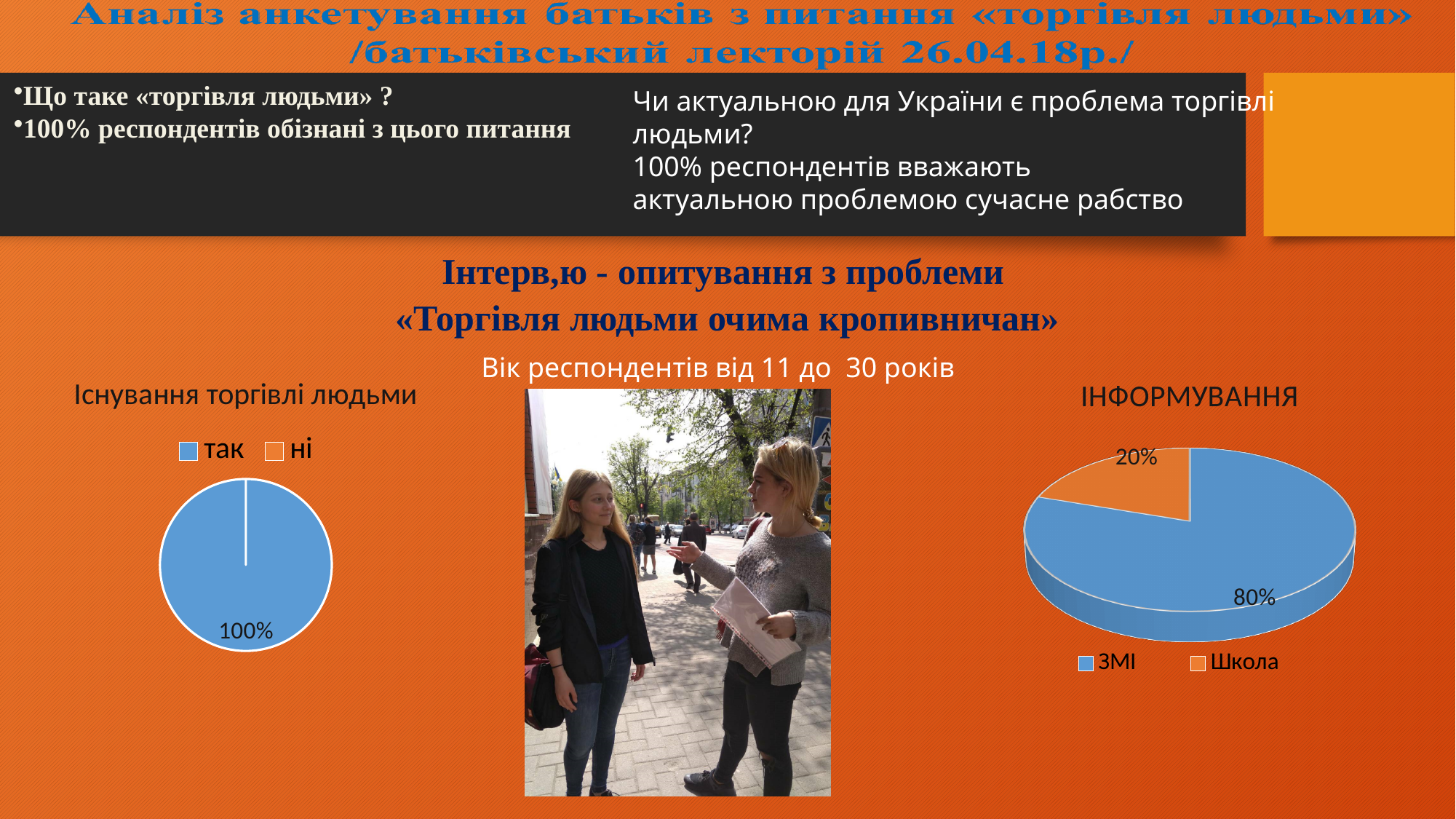
In the chart titled «Існування торгівлі людьми», which legend entry is shown in blue? так In the chart titled «ІНФОРМУВАННЯ», what is the difference between the values for «ЗМІ» and «Школа»? 60% In the chart titled «Існування торгівлі людьми», what share of the pie is labelled for «так»? 100% In the chart titled «ІНФОРМУВАННЯ», what is the value for «ЗМІ»? 80% In the chart titled «Існування торгівлі людьми», how many entries does the legend list? 2 In the chart titled «ІНФОРМУВАННЯ», which is larger, «ЗМІ» or «Школа»? ЗМІ In the chart titled «ІНФОРМУВАННЯ», how many categories does the legend list? 2 What kind of chart is the one titled «ІНФОРМУВАННЯ»? pie chart In the chart titled «ІНФОРМУВАННЯ», which category has the smallest slice? Школа What kind of chart is the one titled «Існування торгівлі людьми»? pie chart In the chart titled «ІНФОРМУВАННЯ», what is the value for «Школа»? 20% In the chart titled «ІНФОРМУВАННЯ», which category has the largest slice? ЗМІ